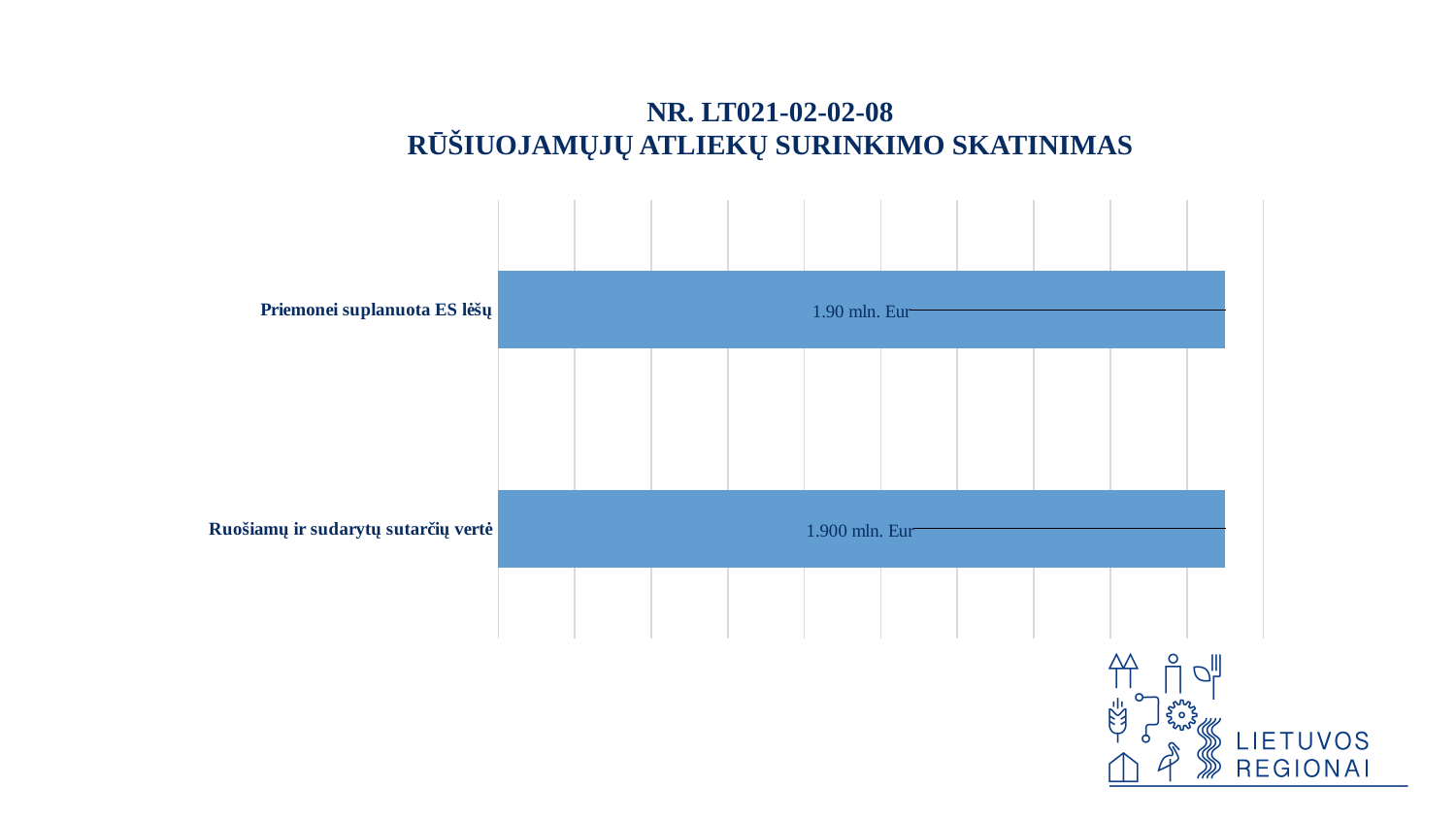
What is the value for "Ruošiamų ir sudarytų sutarčių vertė"? 1.900 mln. Eur What is the value for "Priemonei suplanuota ES lėšų"? 1.90 mln. Eur What kind of chart is shown on the slide? Bar chart Are the bars in the chart horizontal or vertical? Horizontal What is the difference between the value for "Priemonei suplanuota ES lėšų" and the value for "Ruošiamų ir sudarytų sutarčių vertė"? 0 mln. Eur What is the title of the chart? NR. LT021-02-02-08 RŪŠIUOJAMŲJŲ ATLIEKŲ SURINKIMO SKATINIMAS What colour are the bars in the chart? Blue How many categories are plotted in the chart? 2 Which category is listed at the top of the chart? Priemonei suplanuota ES lėšų Is the value for "Priemonei suplanuota ES lėšų" larger than, smaller than, or equal to the value for "Ruošiamų ir sudarytų sutarčių vertė"? Equal